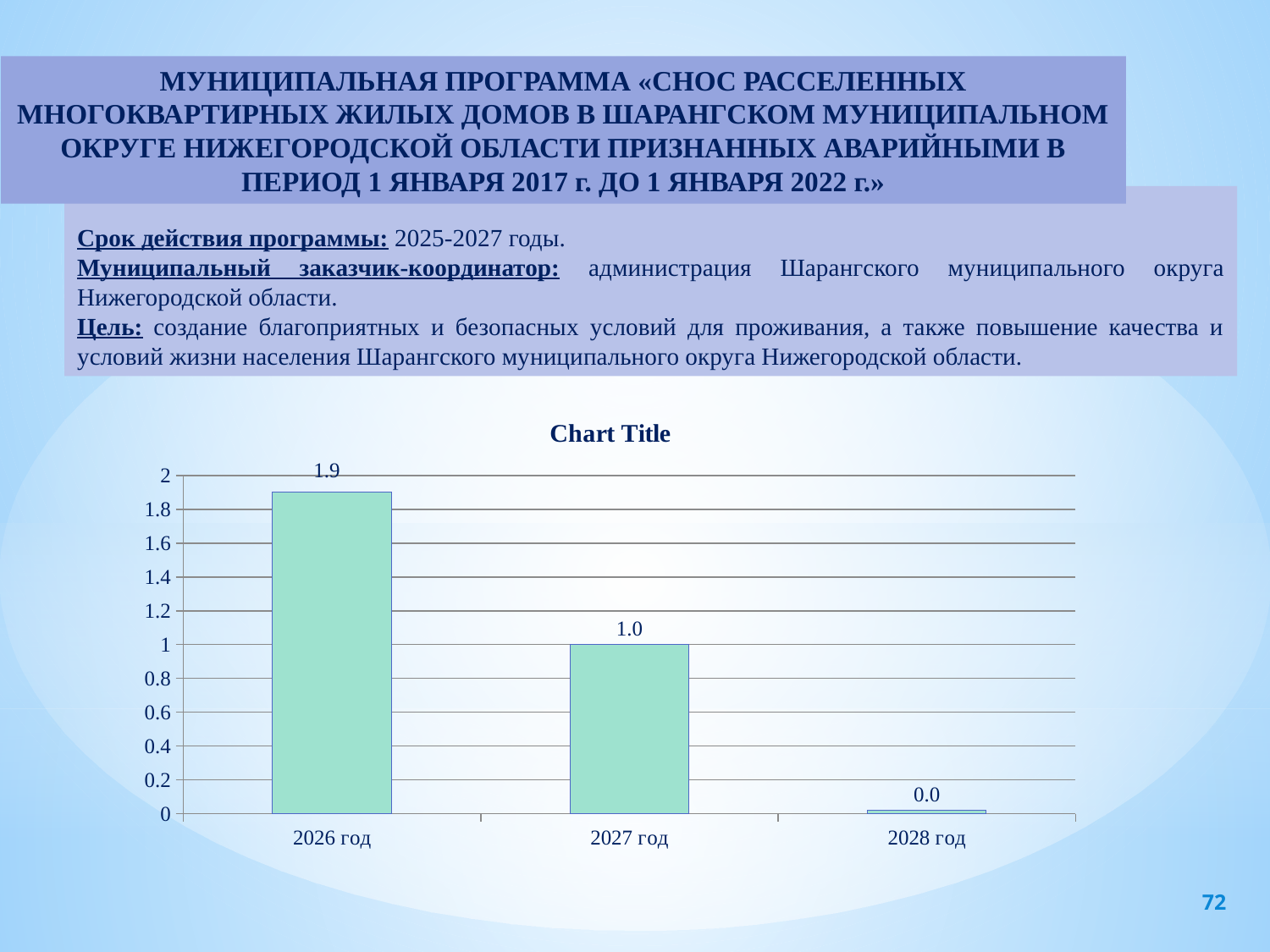
Which is larger, the value for 2027 год or the value for 2028 год? 2027 год Which category has the highest value? 2026 год What is the value for 2026 год? 1.9 How many categories are shown on the x axis? 3 Do the values rise or fall from 2026 год to 2028 год? fall What is the value for 2027 год? 1.0 Is the value for 2026 год greater or less than 1.8? greater What is the difference between the values for 2026 год and 2027 год? 0.9 Which category has the lowest value? 2028 год What is the value for 2028 год? 0.0 What is the title of the chart? Chart Title What kind of chart is shown on the slide? bar chart